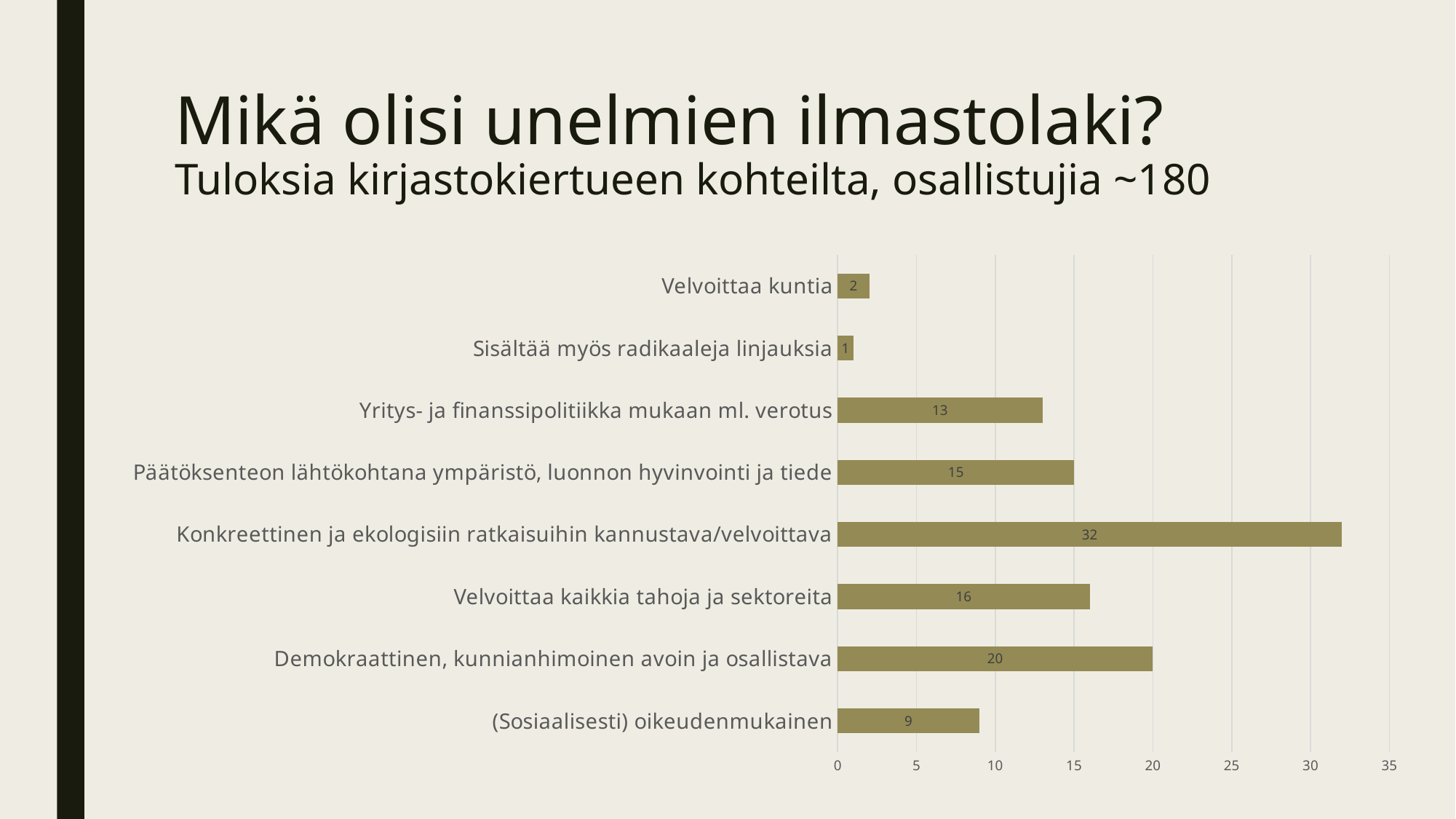
What is the value for "Konkreettinen ja ekologisiin ratkaisuihin kannustava/velvoittava"? 32 What is the difference between the values for "Velvoittaa kaikkia tahoja ja sektoreita" and "Yritys- ja finanssipolitiikka mukaan ml. verotus"? 3 What is the maximum value shown on the horizontal axis? 35 What is the value for "Demokraattinen, kunnianhimoinen avoin ja osallistava"? 20 What is the difference between the values for "Konkreettinen ja ekologisiin ratkaisuihin kannustava/velvoittava" and "Demokraattinen, kunnianhimoinen avoin ja osallistava"? 12 Which category has the highest value? Konkreettinen ja ekologisiin ratkaisuihin kannustava/velvoittava What is the value for "(Sosiaalisesti) oikeudenmukainen"? 9 Which is larger: the value for "Päätöksenteon lähtökohtana ympäristö, luonnon hyvinvointi ja tiede" or the value for "(Sosiaalisesti) oikeudenmukainen"? Päätöksenteon lähtökohtana ympäristö, luonnon hyvinvointi ja tiede How many categories are shown in the chart? 8 What is the value for "Velvoittaa kuntia"? 2 Which category has the lowest value? Sisältää myös radikaaleja linjauksia What kind of chart is shown on the slide? Bar chart